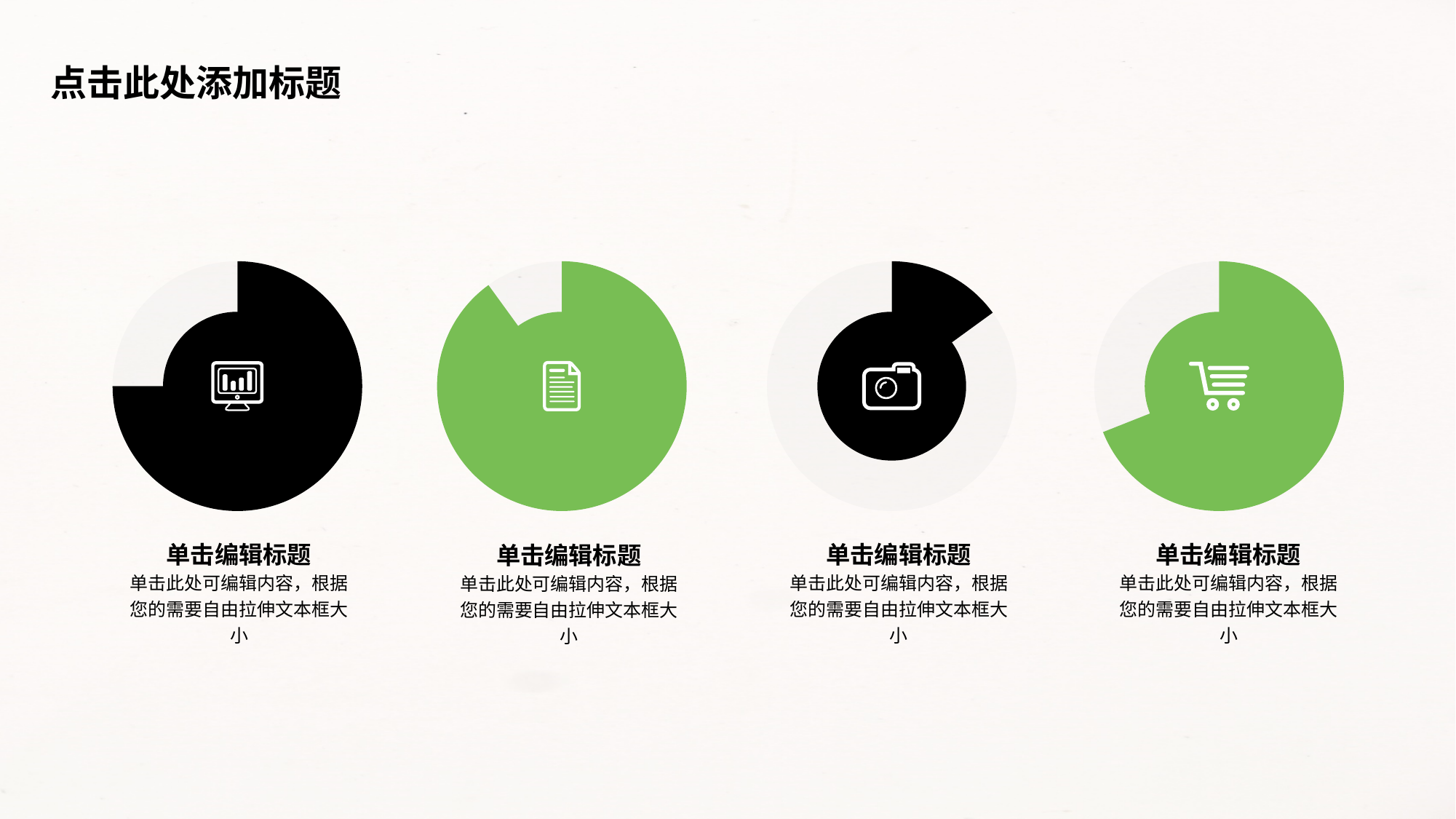
What colour is the filled portion of the second pie chart from the left? green Which of the four pie charts, counted from the left, has the largest filled portion? the second How many pie-style charts are shown on the slide? 4 What colour is the filled portion of the third pie chart from the left? black Is the filled portion of the second pie chart from the left larger or smaller than that of the third pie chart from the left? larger Which of the four pie charts, counted from the left, has the smallest filled portion? the third Is the filled portion of the first pie chart from the left larger or smaller than that of the third pie chart from the left? larger What kind of chart is used for each of the four graphics on the slide? pie chart